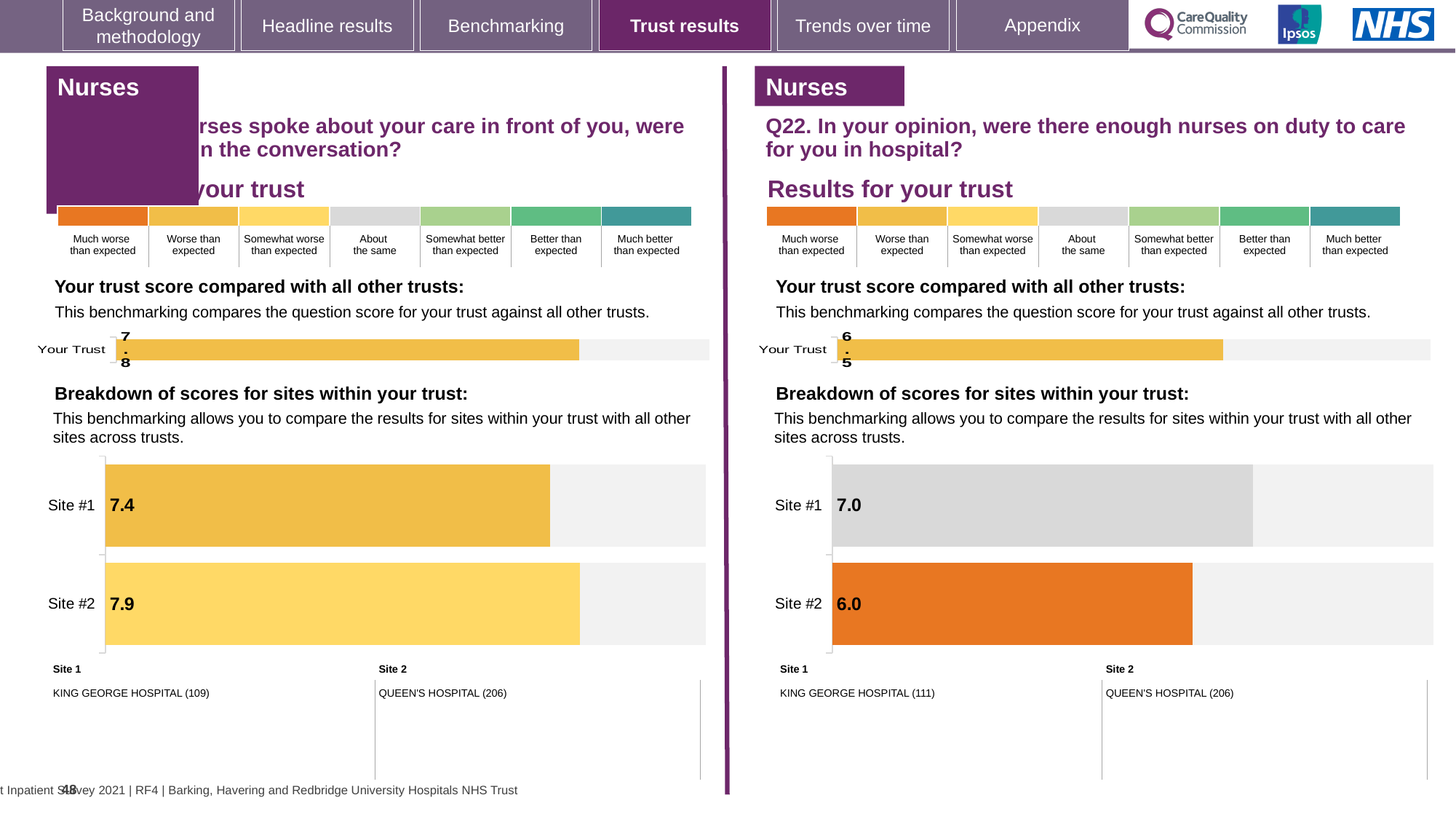
On the right-hand (Q22) 'Your trust score compared with all other trusts' chart, what is the score for Your Trust? 6.5 How many sites are shown on the right-hand (Q22) site breakdown chart? 2 On the right-hand (Q22) site breakdown chart, what is the difference between the scores for Site #1 and Site #2? 1.0 On the right-hand (Q22) 'Breakdown of scores for sites within your trust' chart, what is the score for Site #1? 7.0 On the left-hand site breakdown chart, what is the difference between the scores for Site #2 and Site #1? 0.5 On the right-hand (Q22) site breakdown chart, which site has the lower score? Site #2 On the left-hand site breakdown chart, which site has the higher score? Site #2 What type of chart is used for the site breakdown on the left-hand side of the slide? Bar chart On the left-hand 'Breakdown of scores for sites within your trust' chart, what is the score for Site #2? 7.9 On the left-hand 'Your trust score compared with all other trusts' chart, what is the score for Your Trust? 7.8 On the right-hand (Q22) 'Breakdown of scores for sites within your trust' chart, what is the score for Site #2? 6.0 On the left-hand 'Breakdown of scores for sites within your trust' chart, what is the score for Site #1? 7.4